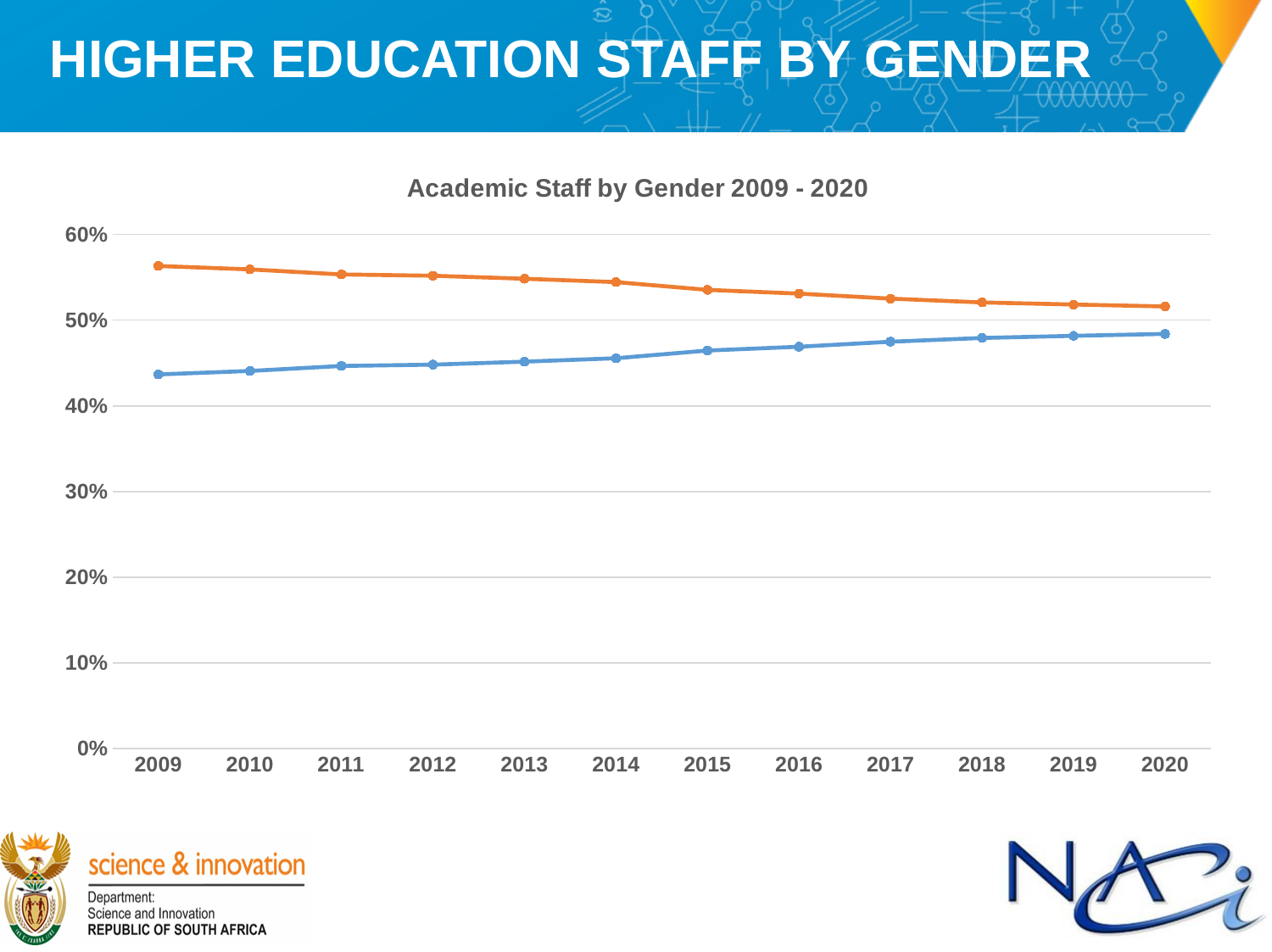
Does the orange line rise or fall from 2009 to 2020? Fall Is the value of the orange line in 2020 greater or less than 60%? less What kind of chart is shown on the slide? Line chart How many years are shown along the x axis of the chart? 12 Is the value of the orange line in 2009 greater or less than 50%? greater Is the value of the blue line in 2020 greater or less than 40%? greater What is the title of the chart? Academic Staff by Gender 2009 - 2020 Does the blue line rise or fall from 2009 to 2020? Rise In 2020, which line has the higher value, the orange line or the blue line? The orange line How many lines are plotted on the chart? 2 In which year is the orange line at its highest value? 2009